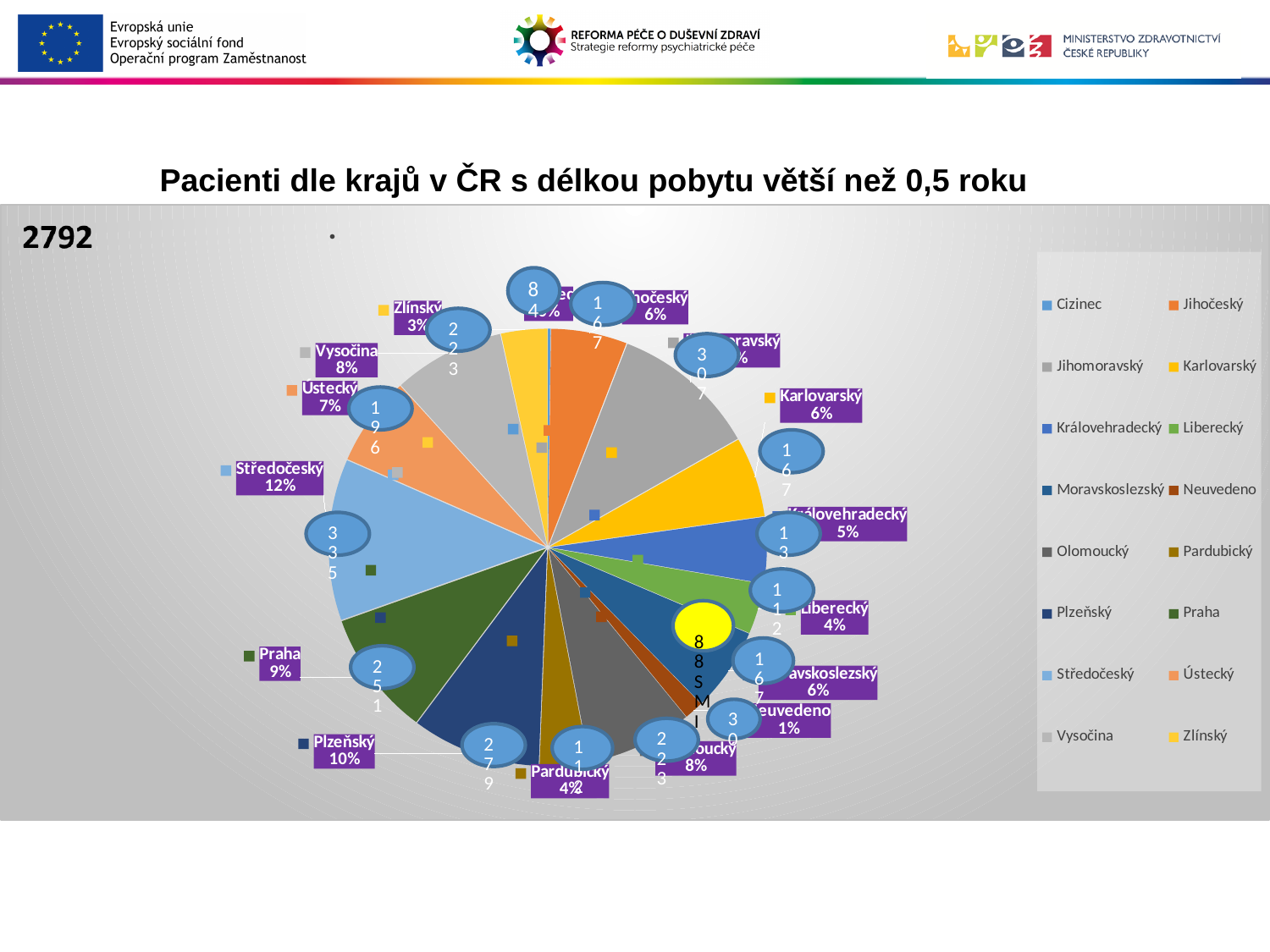
What share of the pie does Vysočina have? 8% What kind of chart is shown on the slide? pie chart How many entries does the legend of the pie chart list? 16 What total number is printed in the top-left corner of the chart area? 2792 Which has the larger share of the pie, Karlovarský or Královehradecký? Karlovarský What share of the pie does Liberecký have? 4% What share of the pie does Ústecký have? 7% By how many percentage points does the share of Středočeský exceed the share of Zlínský? 9 Which has the larger share of the pie, Plzeňský or Praha? Plzeňský